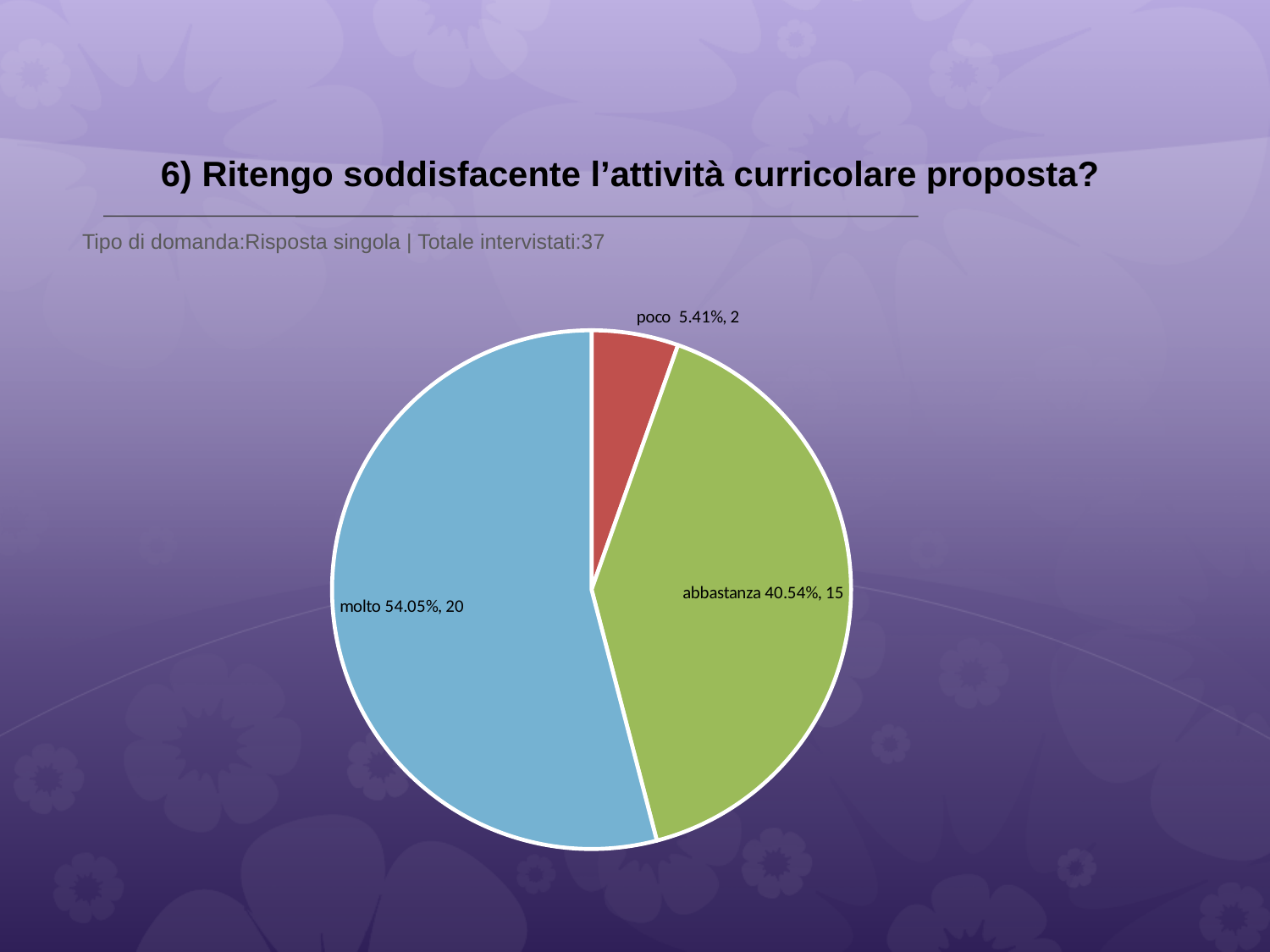
What kind of chart is shown on the slide? pie chart Which response category has the smallest slice? poco What is the difference in respondent count between 'molto' and 'abbastanza'? 5 How many respondents answered 'poco'? 2 What percentage share does the 'molto' slice have? 54.05% How many slices does the pie chart have? 3 How many respondents answered 'molto'? 20 Which slice is larger, 'abbastanza' or 'poco'? abbastanza What percentage share does the 'abbastanza' slice have? 40.54% Which response category has the largest slice? molto How many respondents answered 'abbastanza'? 15 What percentage share does the 'poco' slice have? 5.41%